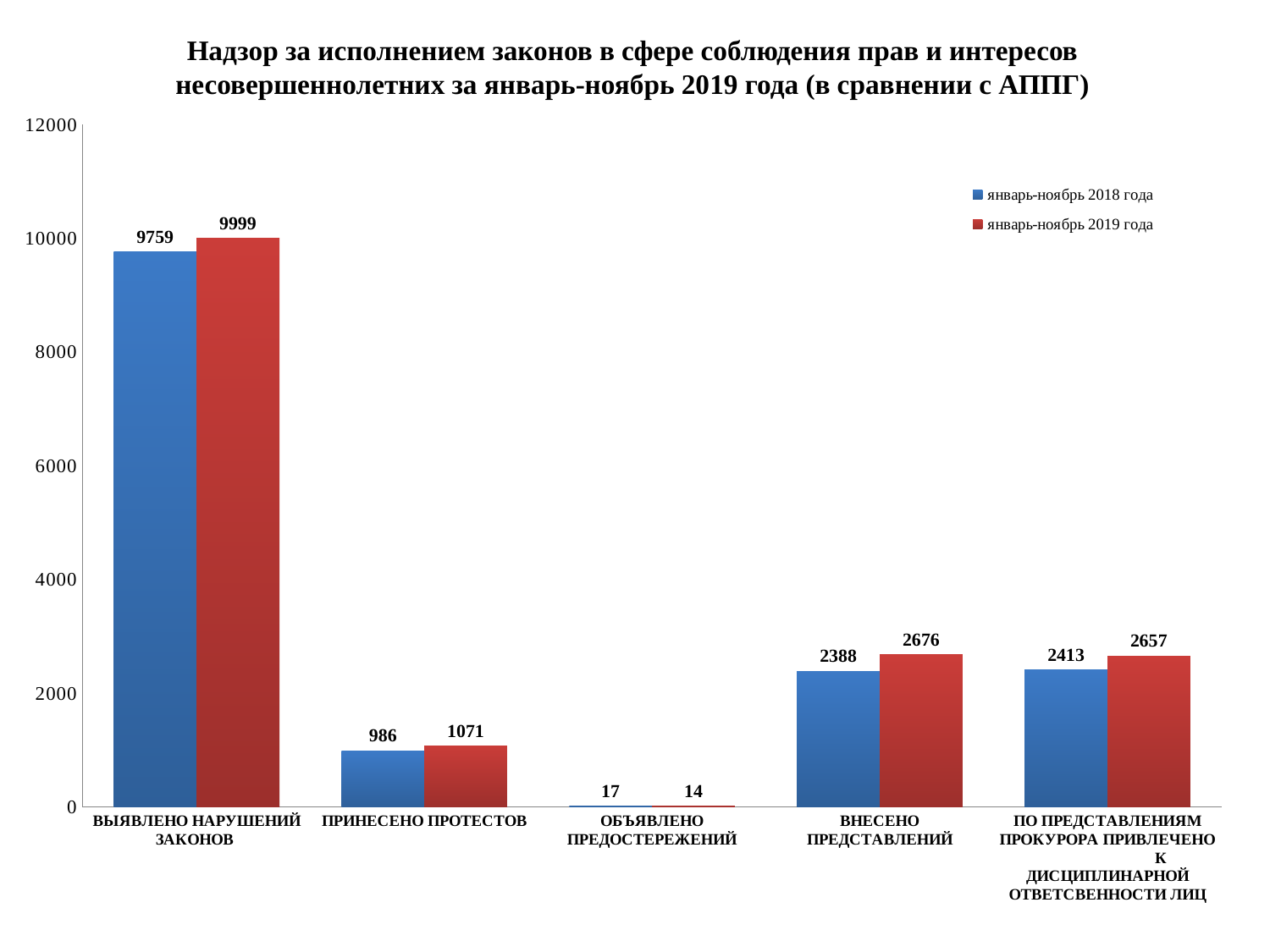
Is the value for ПРИНЕСЕНО ПРОТЕСТОВ in the январь-ноябрь 2019 года series greater or less than 2000? less What is the value for ОБЪЯВЛЕНО ПРЕДОСТЕРЕЖЕНИЙ in the январь-ноябрь 2019 года series? 14 How many categories are shown on the x axis? 5 How many series does the legend list? 2 Which category has the lowest value in the январь-ноябрь 2019 года series? ОБЪЯВЛЕНО ПРЕДОСТЕРЕЖЕНИЙ Which is larger for ОБЪЯВЛЕНО ПРЕДОСТЕРЕЖЕНИЙ: the январь-ноябрь 2018 года value or the январь-ноябрь 2019 года value? январь-ноябрь 2018 года Which colour represents the январь-ноябрь 2019 года series? red What is the value for ПРИНЕСЕНО ПРОТЕСТОВ in the январь-ноябрь 2018 года series? 986 What is the difference between the 2019 and 2018 values for ВНЕСЕНО ПРЕДСТАВЛЕНИЙ? 288 What kind of chart is shown on the slide? bar chart Which category has the highest value in the январь-ноябрь 2018 года series? ВЫЯВЛЕНО НАРУШЕНИЙ ЗАКОНОВ What is the value for ВЫЯВЛЕНО НАРУШЕНИЙ ЗАКОНОВ in the январь-ноябрь 2019 года series? 9999